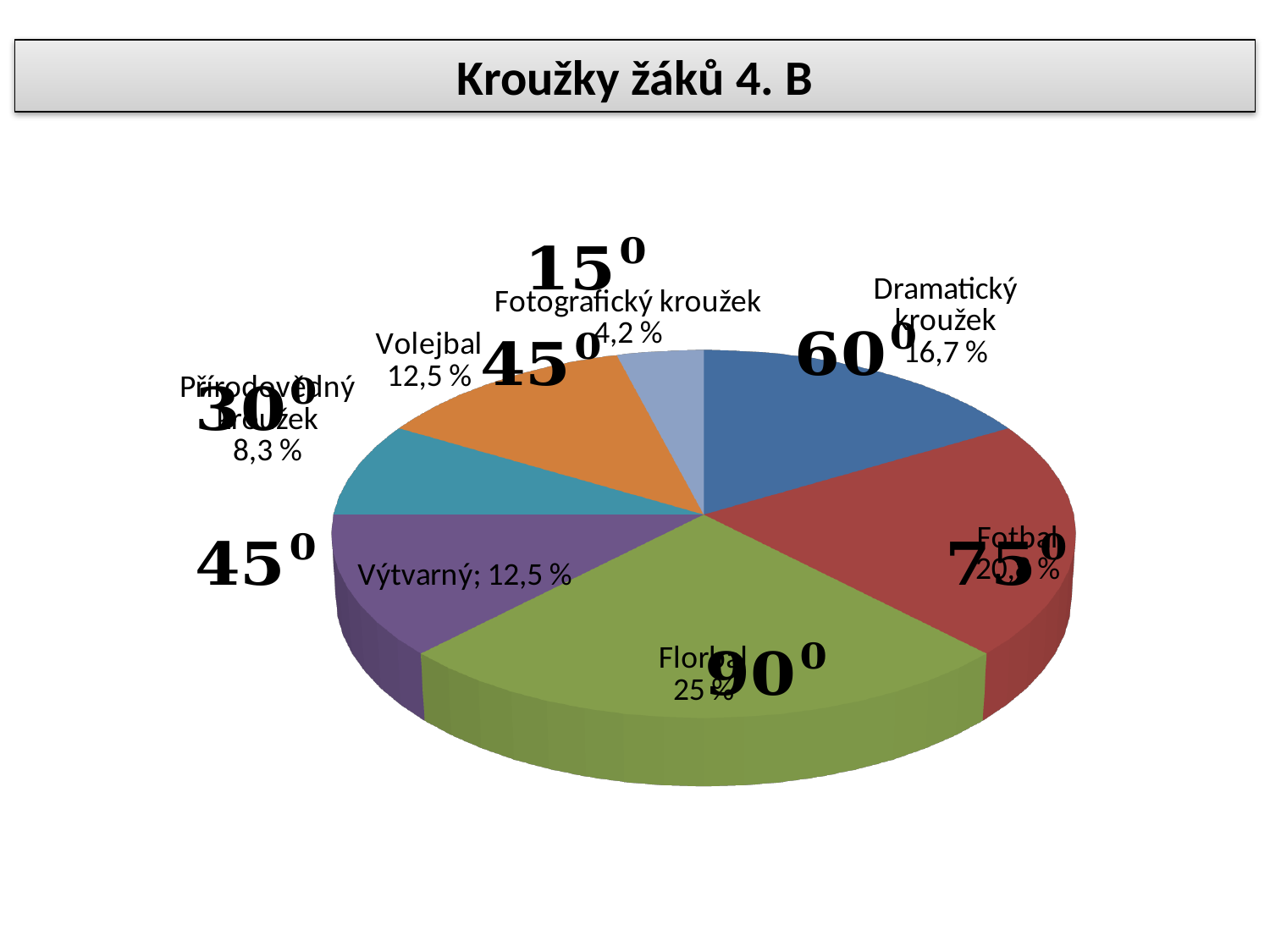
What share of the pie does Fotografický kroužek have? 4,2 % What share of the pie does Výtvarný have? 12,5 % How many slices does the pie chart have? 7 What is the title of the chart? Kroužky žáků 4. B Which slice is the smallest in the pie chart? Fotografický kroužek Which has a larger share, Dramatický kroužek or Volejbal? Dramatický kroužek What kind of chart is shown on the slide? pie chart What is the difference in percentage points between the Florbal share and the Přírodovědný kroužek share? 16,7 % What share of the pie does Dramatický kroužek have? 16,7 % Which slice is the largest in the pie chart? Florbal What share of the pie does Přírodovědný kroužek have? 8,3 % What share of the pie does Florbal have? 25 %